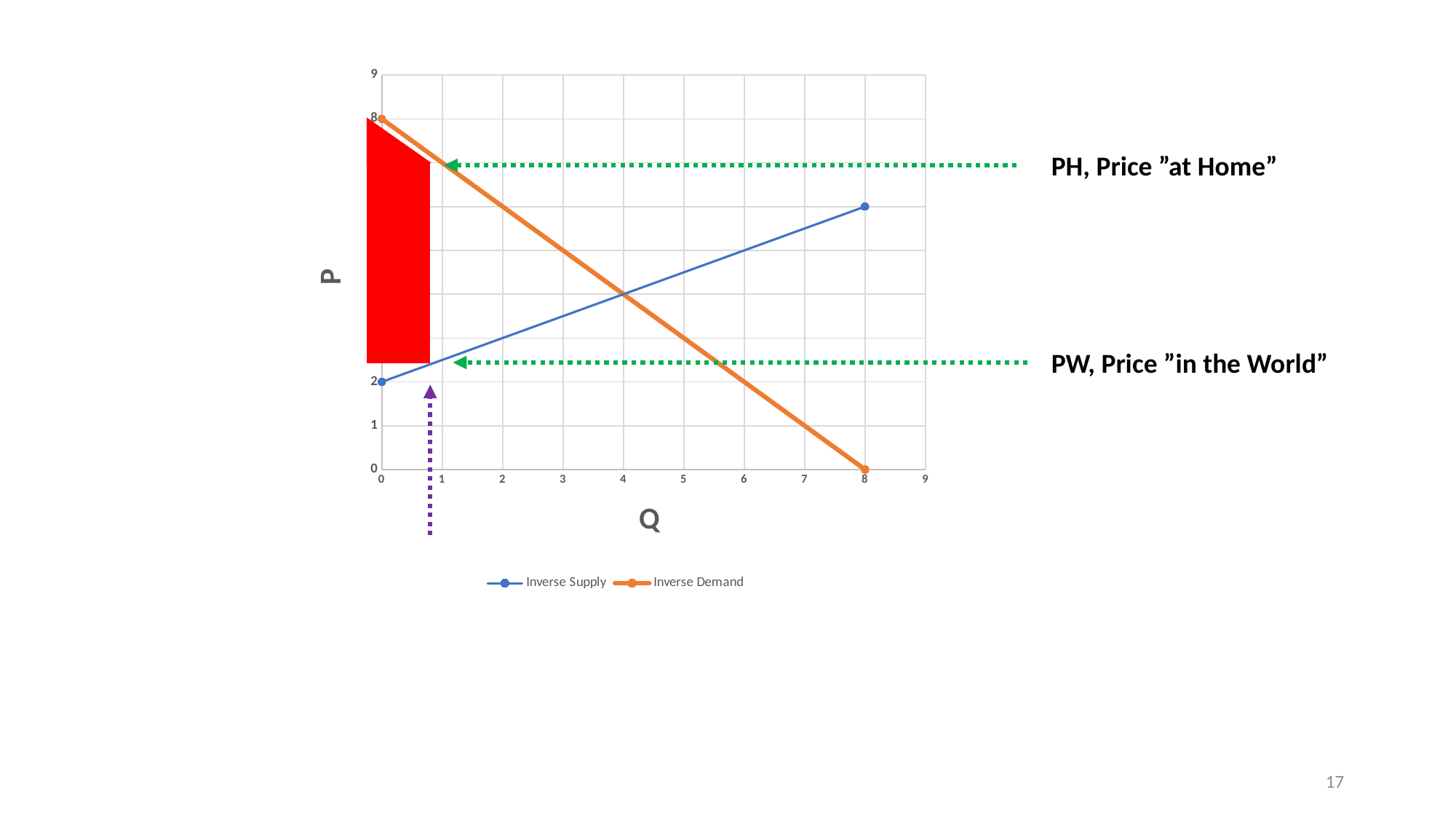
What is the value of Inverse Demand at Q = 8? 0 Does the Inverse Supply line rise or fall as Q increases? rise What are the two series named in the legend? Inverse Supply and Inverse Demand At Q = 0, which series has the higher value, Inverse Supply or Inverse Demand? Inverse Demand What is the value of Inverse Supply at Q = 0? 2 Does the Inverse Demand line rise or fall as Q increases? fall What is the difference between Inverse Demand and Inverse Supply at Q = 0? 6 At Q = 8, which series has the higher value, Inverse Supply or Inverse Demand? Inverse Supply Is the value of Inverse Supply at Q = 8 greater or less than 2? greater What is the value of Inverse Demand at Q = 0? 8 How many series does the legend list? 2 What kind of chart is shown on the slide? line chart